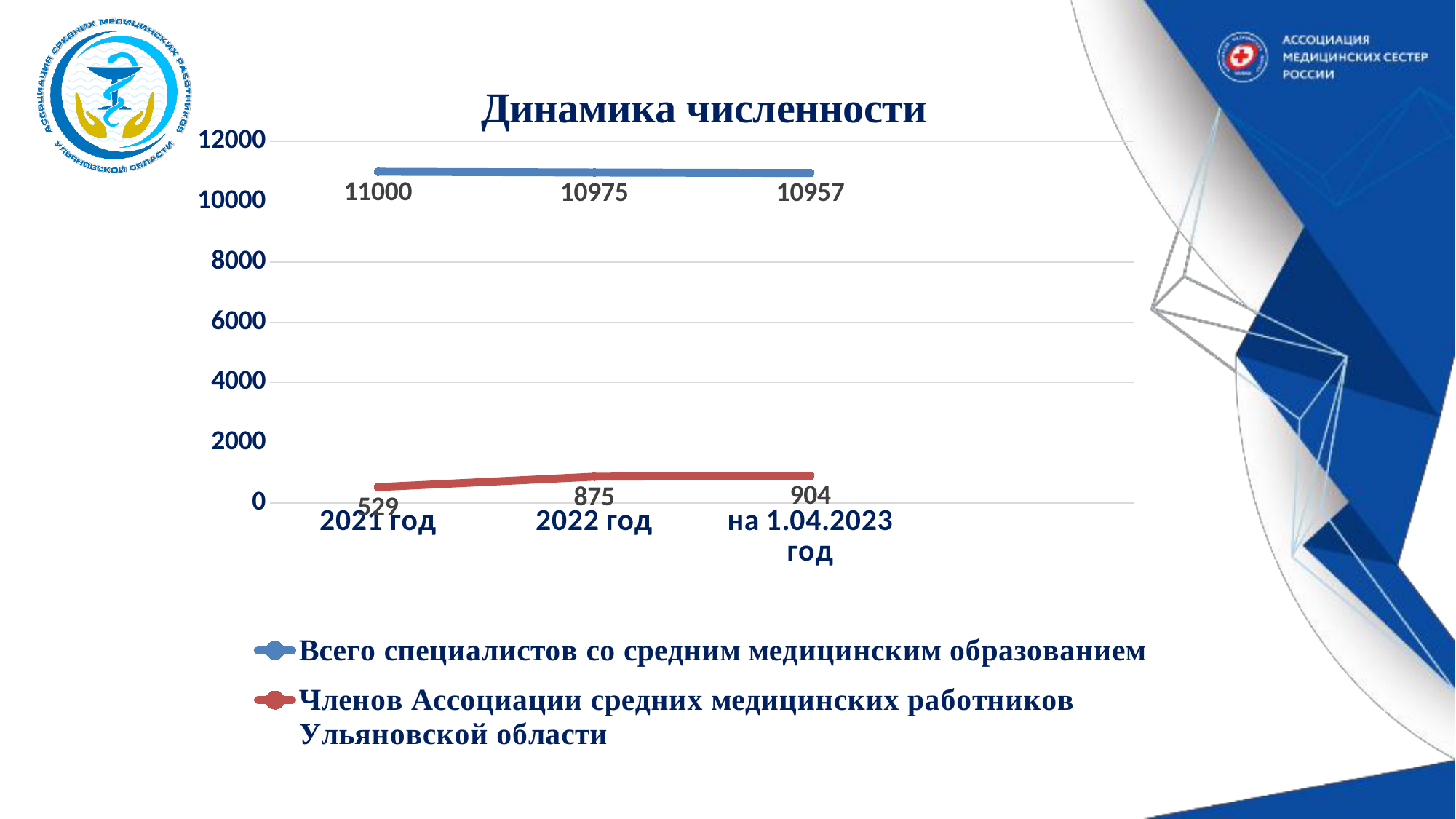
What is the difference between the 'Всего специалистов' values for 2021 год and 2022 год? 25 What is the value for 'Членов Ассоциации средних медицинских работников Ульяновской области' на 1.04.2023 год? 904 What is the value for 'Всего специалистов со средним медицинским образованием' на 1.04.2023 год? 10957 How many periods are shown on the x axis? 3 In which period is the value for 'Членов Ассоциации средних медицинских работников Ульяновской области' lowest? 2021 год How many series does the legend list? 2 Which series has the larger value in 2022 год: 'Всего специалистов со средним медицинским образованием' or 'Членов Ассоциации средних медицинских работников Ульяновской области'? Всего специалистов со средним медицинским образованием In which period is the value for 'Всего специалистов со средним медицинским образованием' highest? 2021 год What is the value for 'Членов Ассоциации средних медицинских работников Ульяновской области' in 2022 год? 875 What is the difference between the 'Членов Ассоциации' values for 2022 год and 2021 год? 346 What is the value for 'Всего специалистов со средним медицинским образованием' in 2021 год? 11000 What kind of chart is this? line chart